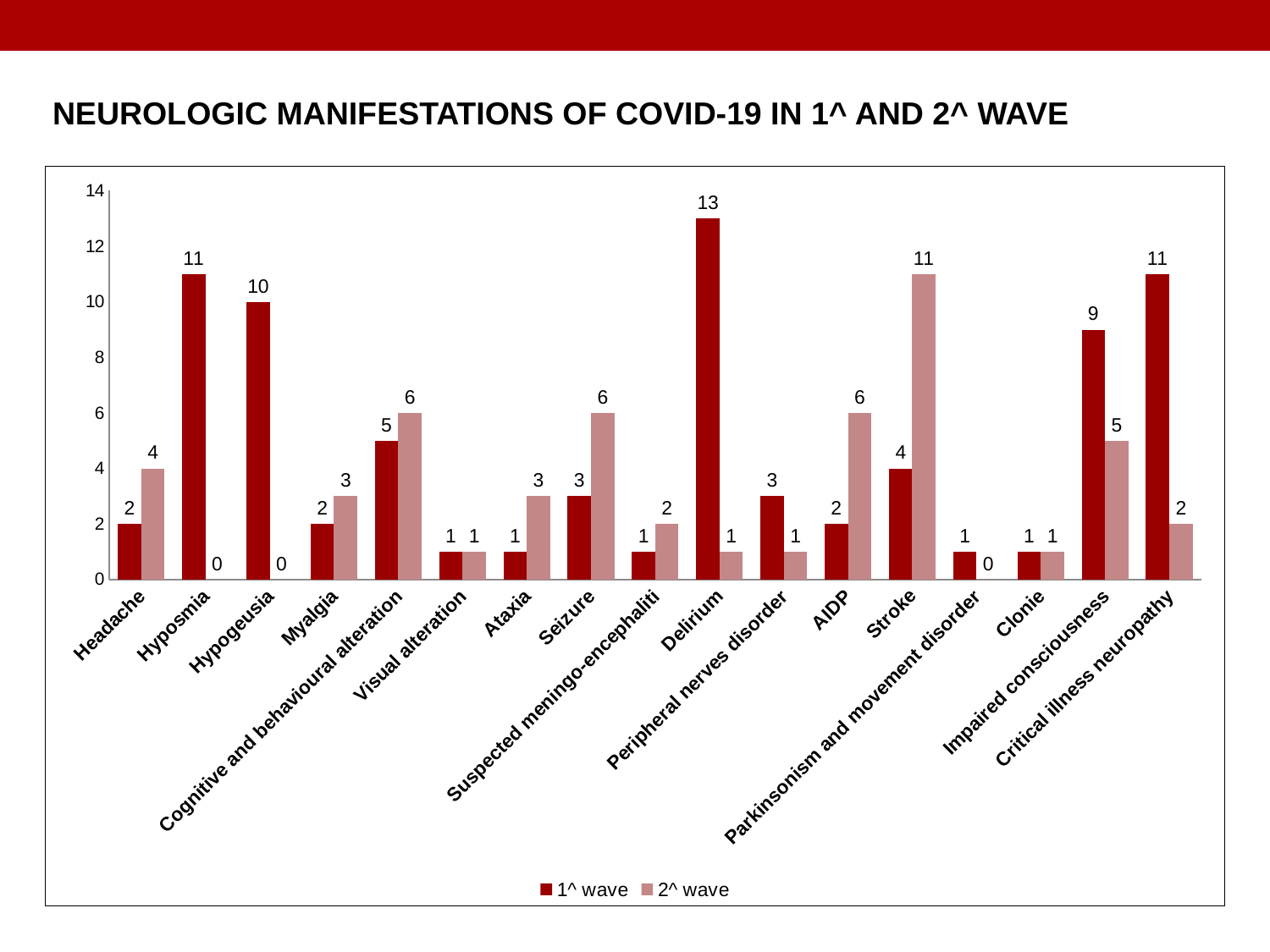
Which is larger for AIDP, the 1^ wave value or the 2^ wave value? 2^ wave Which category has the highest 1^ wave value? Delirium How many series does the legend list? 2 What is the 2^ wave value for Stroke? 11 What is the 2^ wave value for Hyposmia? 0 What is the 1^ wave value for Impaired consciousness? 9 What is the difference between the 1^ wave and 2^ wave values for Critical illness neuropathy? 9 What is the 1^ wave value for Delirium? 13 What kind of chart is shown on the slide? Bar chart What is the title of the chart? NEUROLOGIC MANIFESTATIONS OF COVID-19 IN 1^ AND 2^ WAVE How many categories are shown on the x axis? 17 Which category has the highest 2^ wave value? Stroke